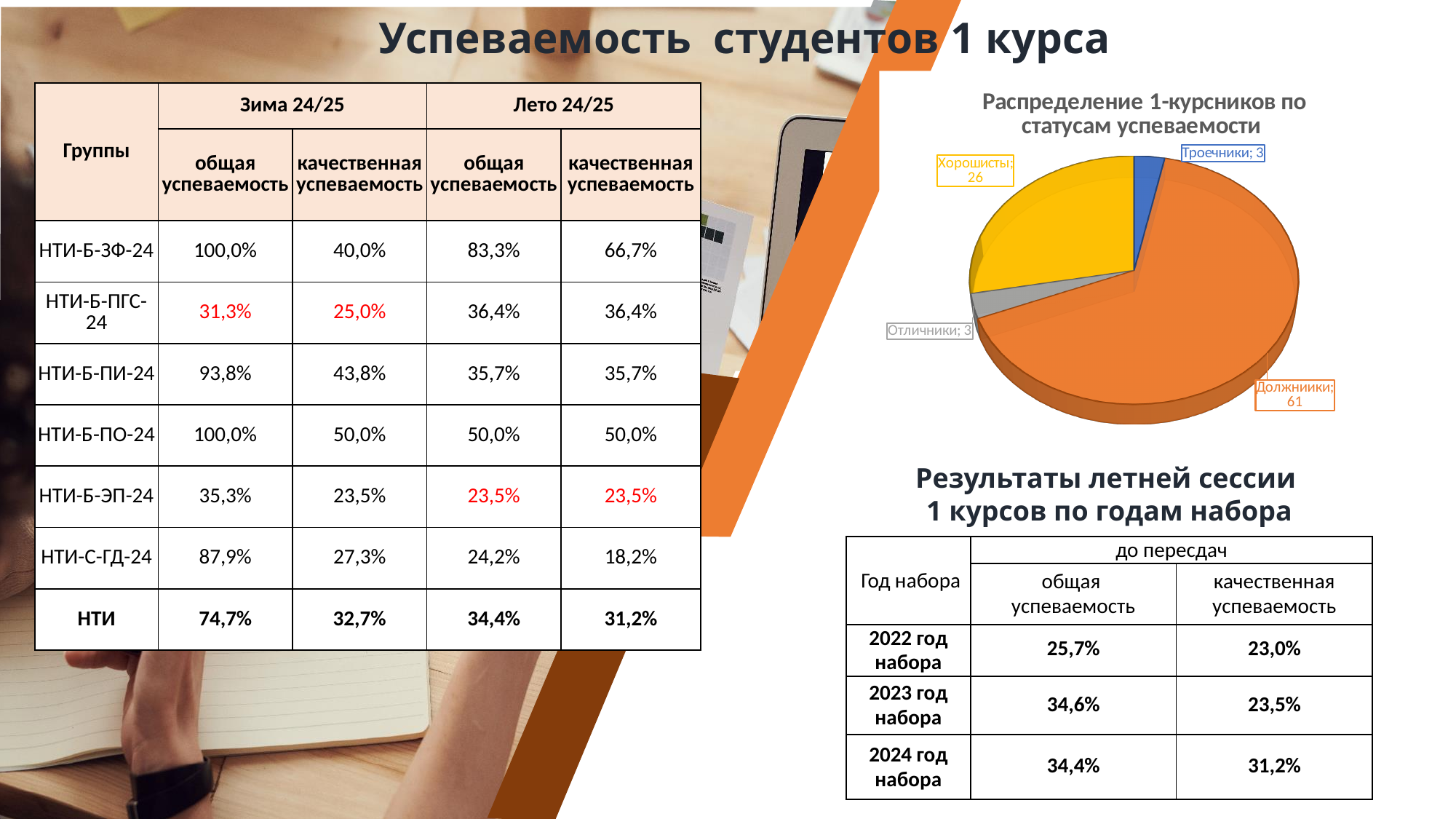
What is the total number of students represented across all slices of the pie chart? 93 In the pie chart, what is the value shown for Троечники? 3 What colour is the Должники slice in the pie chart? Orange In the pie chart, how many students are labelled as Должники? 61 What kind of chart is shown on the slide under the title "Распределение 1-курсников по статусам успеваемости"? Pie chart In the pie chart, what is the value shown for Хорошисты? 26 In the pie chart, what is the difference between the number of Должники and the number of Хорошисты? 35 In the pie chart, what is the value shown for Отличники? 3 Which category has the largest slice in the pie chart? Должники What share of the pie chart do the Должники make up? 65.6% In the pie chart, which is larger: Хорошисты or Должники? Должники How many categories (slices) does the pie chart have? 4